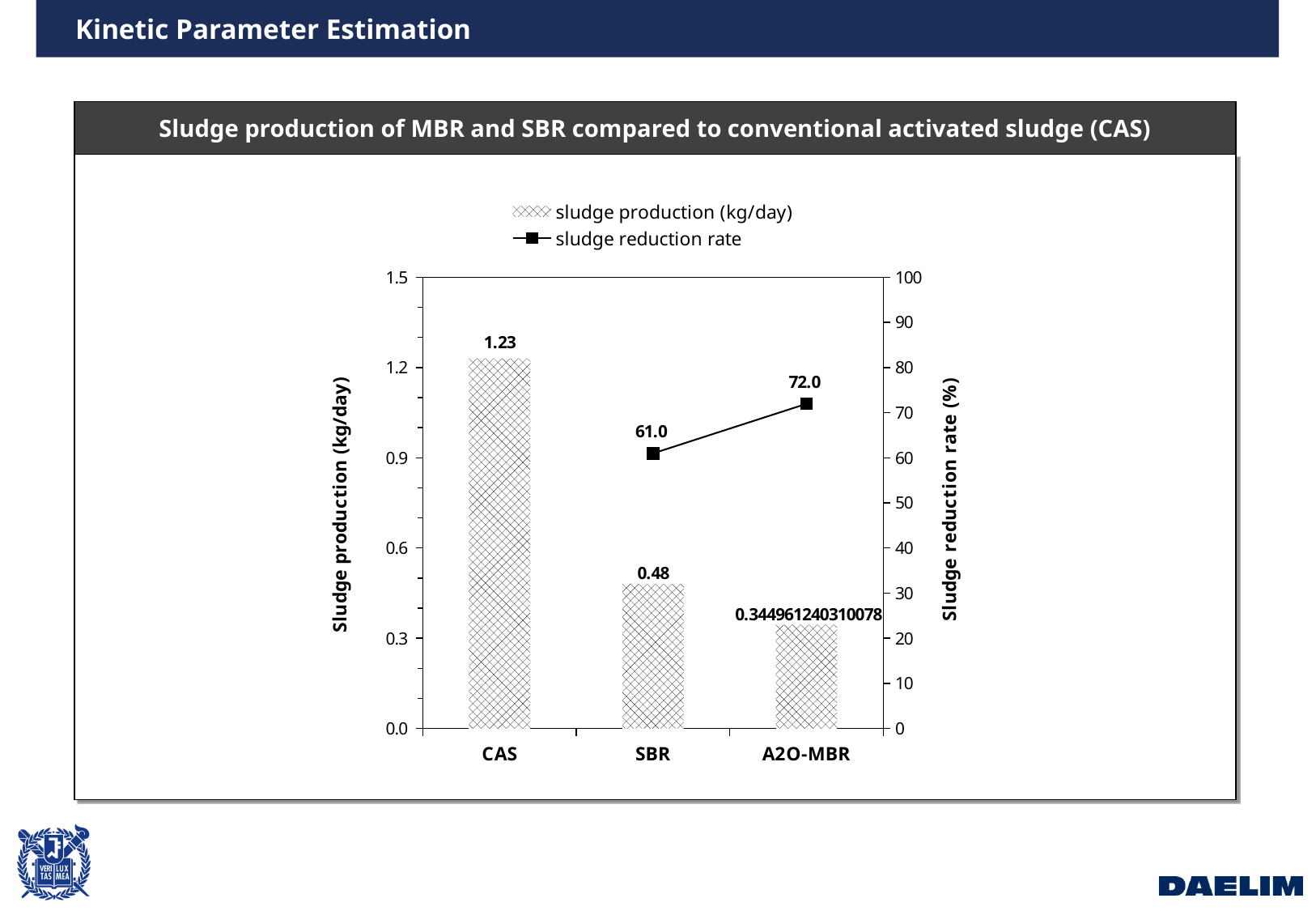
What is the sludge production (kg/day) for CAS? 1.23 What is the difference in sludge production (kg/day) between CAS and SBR? 0.75 Which has a higher sludge reduction rate, SBR or A2O-MBR? A2O-MBR Which category has the highest sludge production (kg/day)? CAS What is the sludge production (kg/day) for SBR? 0.48 What is the difference in sludge reduction rate between A2O-MBR and SBR? 11.0 What is the title of the chart? Sludge production of MBR and SBR compared to conventional activated sludge (CAS) Which category has the lowest sludge production (kg/day)? A2O-MBR How many series does the legend list? 2 What is the sludge reduction rate for SBR? 61.0 What is the sludge reduction rate for A2O-MBR? 72.0 How many categories are shown on the x axis? 3